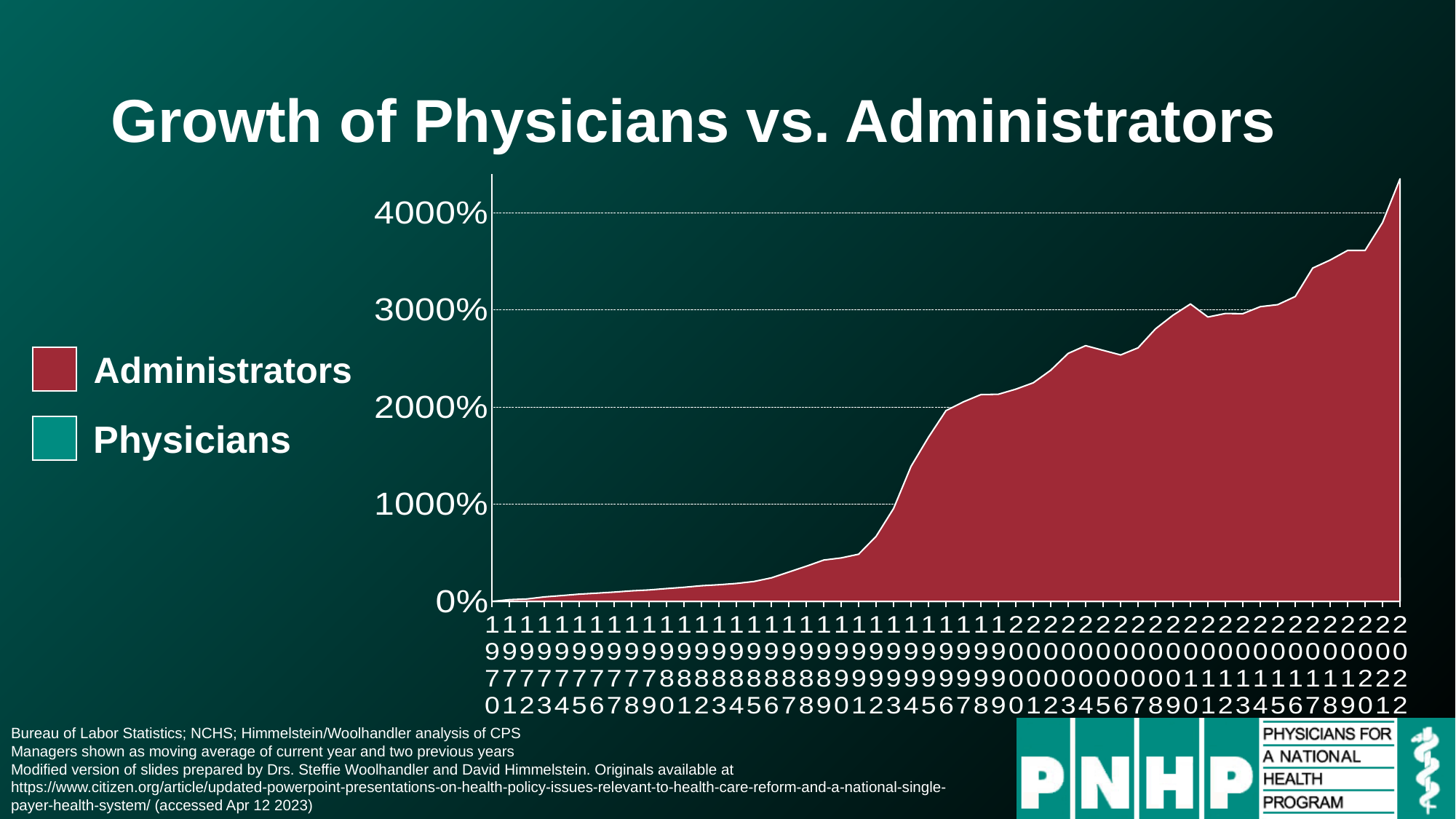
Is the Administrators value for 1990 greater or less than 1000%? less Is the Administrators value for 1980 greater or less than 1000%? less What kind of chart is shown on the slide? area chart Is the Administrators value for 2020 greater or less than 3000%? greater How many series does the legend list? 2 What is the first year shown on the x axis? 1970 Which series is shown in red? Administrators In which year is the Administrators value highest? 2022 What is the title of the chart? Growth of Physicians vs. Administrators Do the Administrators values generally rise or fall from 1970 to 2022? rise